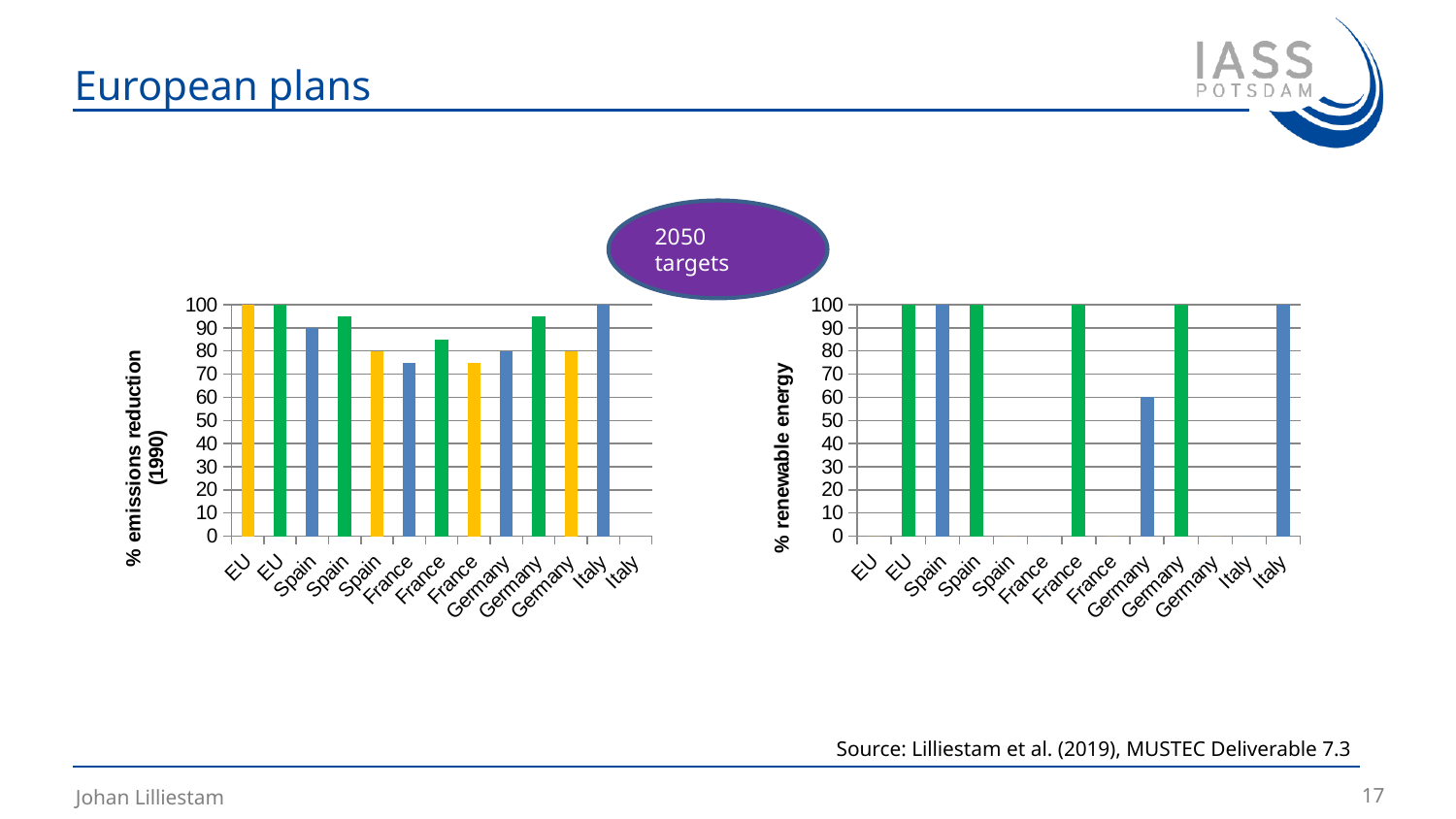
How many category labels are on the x axis of the left chart (% emissions reduction)? 13 What is the y-axis title of the left chart? % emissions reduction (1990) In the left chart (% emissions reduction), which is larger: the first Spain bar or the first France bar? the first Spain bar In the left chart (% emissions reduction), is the value for the first Spain bar greater or less than 80? greater In the right chart (% renewable energy), what value does the first Germany bar reach? 60 What is the y-axis title of the right chart? % renewable energy In the right chart (% renewable energy), which is larger: the first Germany bar or the second Germany bar? the second Germany bar In the right chart (% renewable energy), is the value for the first Germany bar greater or less than 80? less In the left chart (% emissions reduction), is the value for the first France bar greater or less than 80? less In the left chart (% emissions reduction), what value does the first EU bar reach? 100 What kind of chart is the left chart (% emissions reduction)? bar chart How many bars are visible in the right chart (% renewable energy)? 7